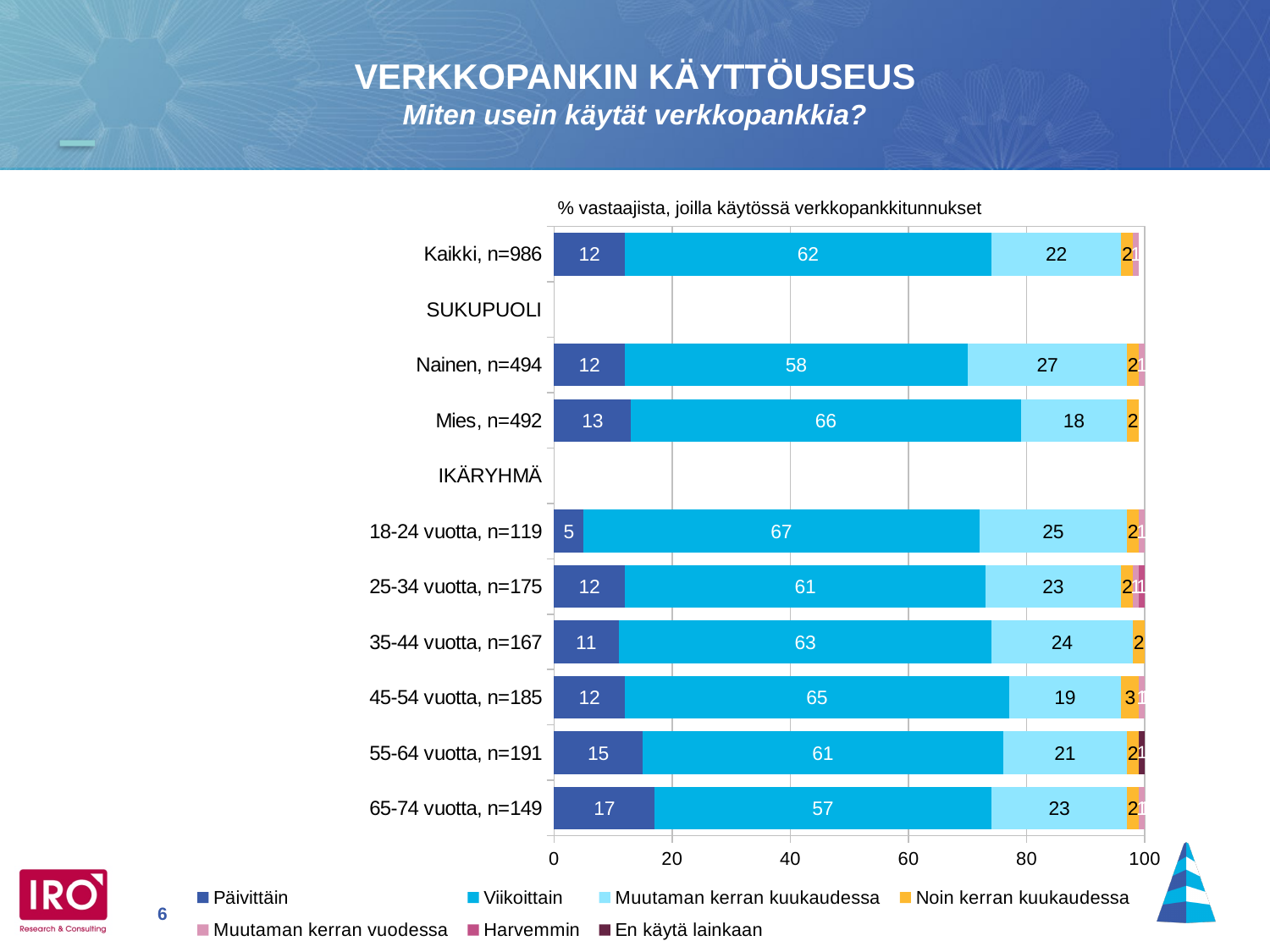
What kind of chart is shown on the slide? Stacked bar chart What percentage of respondents aged 65-74 (n=149) use online banking daily (Päivittäin)? 17 Which age group has the lowest Päivittäin (daily) share? 18-24 vuotta, n=119 How many age groups (IKÄRYHMÄ) are plotted in the chart? 6 What is the difference between the Viikoittain values for Mies (n=492) and Nainen (n=494)? 8 What is the Viikoittain (weekly) value for Mies, n=492? 66 Which has the larger Muutaman kerran kuukaudessa value, Nainen or Mies? Nainen How many series does the legend list? 7 What is the Muutaman kerran kuukaudessa value for Nainen, n=494? 27 Which age group has the highest Viikoittain (weekly) share? 18-24 vuotta, n=119 What is the Viikoittain value for Kaikki, n=986? 62 Which age group has the highest Päivittäin (daily) share? 65-74 vuotta, n=149